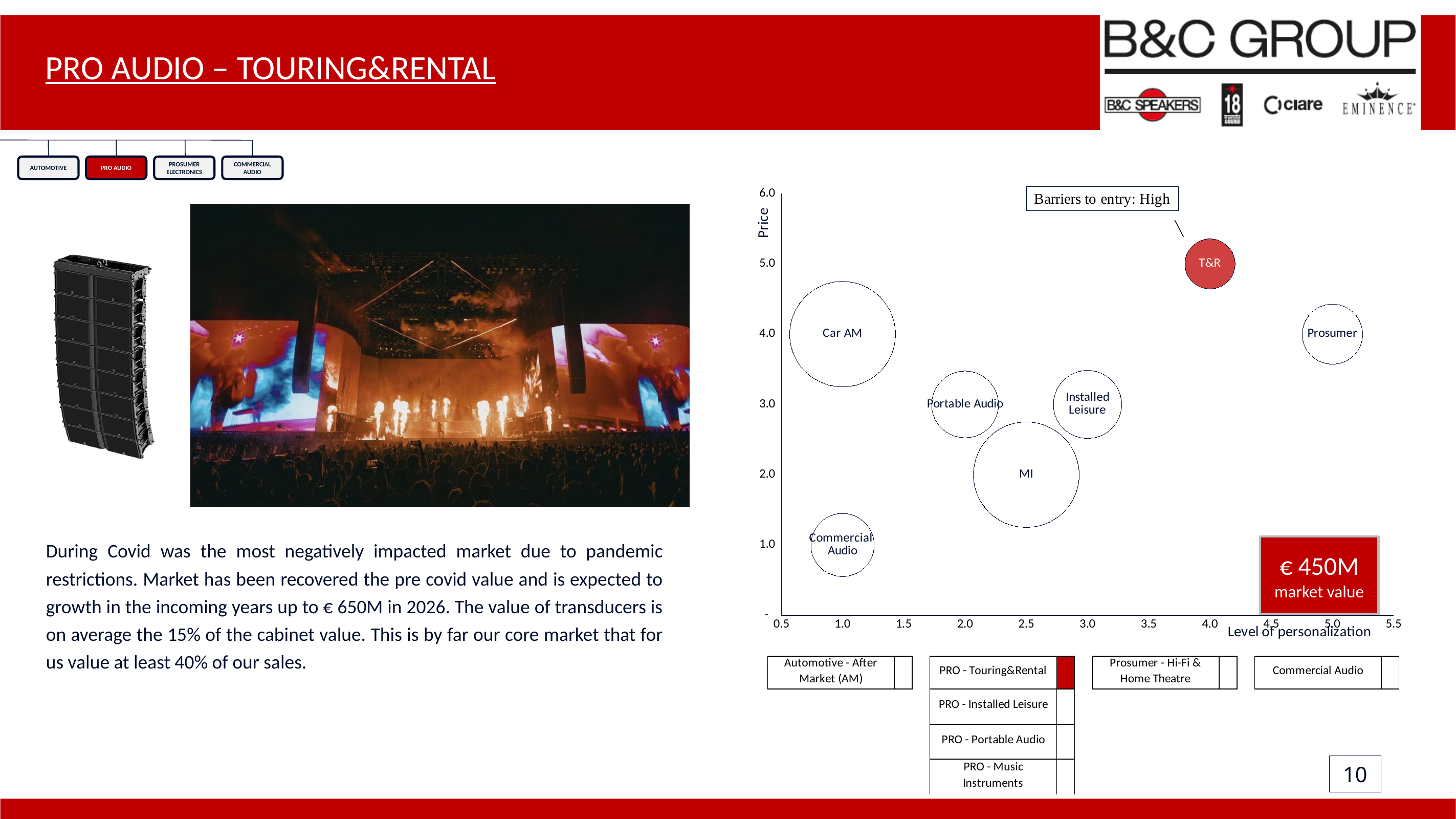
What kind of chart is shown on the right of the slide? Bubble chart Is the Price value for T&R greater or less than 4.0? greater Which bubble is highlighted in red on the chart? T&R How many bubbles (market segments) are plotted on the chart? 7 Is the Price value for MI greater or less than 3.0? less Which bubble has the highest Price value on the chart? T&R How many entries does the legend below the chart list? 7 Which bubble has the lowest Price value on the chart? Commercial Audio What is the label of the vertical axis of the chart? Price Which bubble has the highest Level of personalization on the chart? Prosumer Which has a higher Price value, Car AM or Commercial Audio? Car AM Is the Level of personalization for Car AM greater or less than 1.5? less